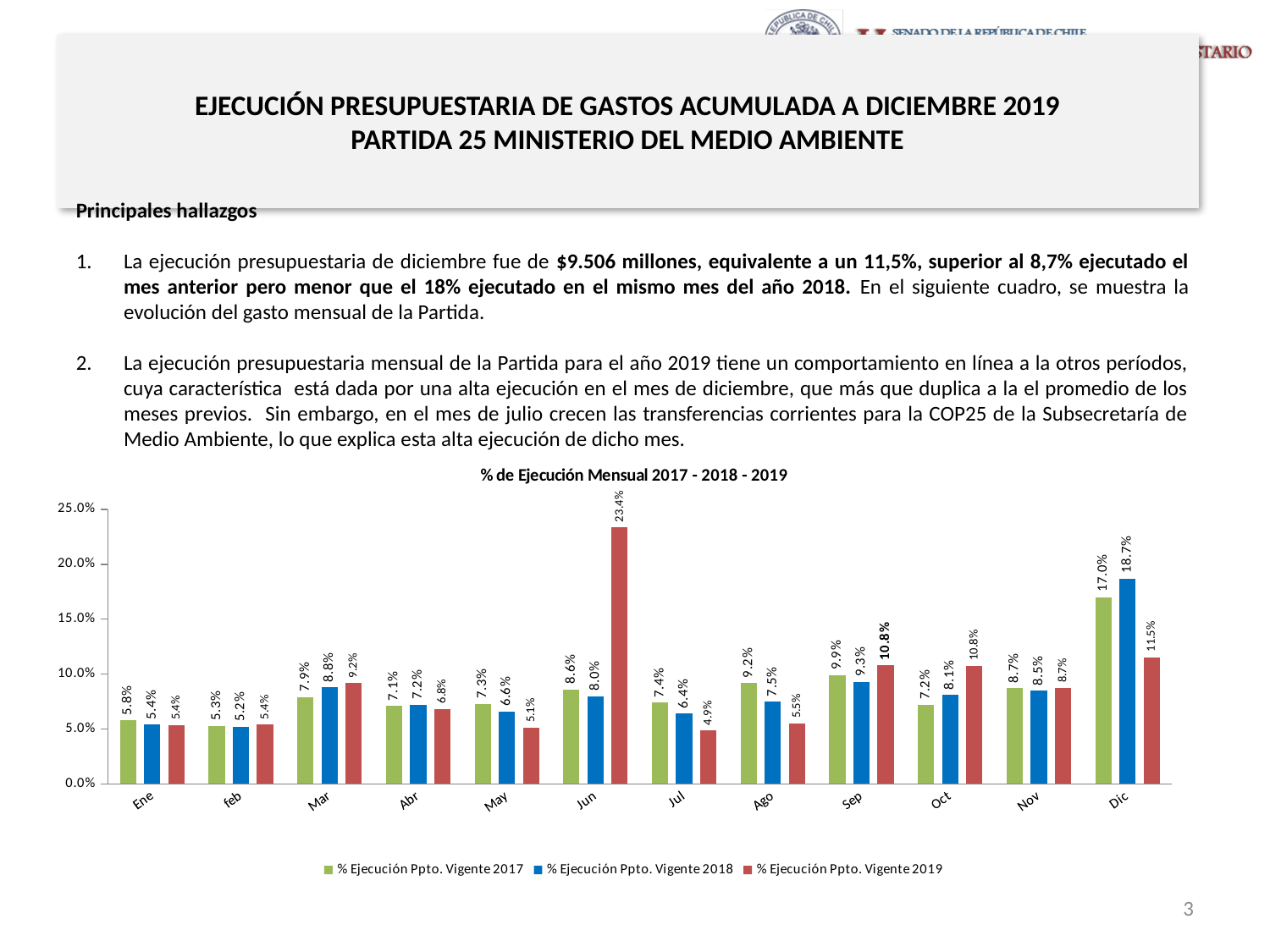
Is the value for % Ejecución Ppto. Vigente 2017 in Dic greater or less than 15.0%? greater What is the value for % Ejecución Ppto. Vigente 2019 in Jun? 23.4% In which month is the % Ejecución Ppto. Vigente 2019 value highest? Jun How many series does the legend of the chart list? 3 What is the value for % Ejecución Ppto. Vigente 2017 in Sep? 9.9% What type of chart is shown on the slide? bar chart How many months are shown on the x axis of the chart? 12 What is the value for % Ejecución Ppto. Vigente 2018 in Dic? 18.7% In which month is the % Ejecución Ppto. Vigente 2019 value lowest? Jul What is the difference between the 2018 and 2019 values in Dic? 7.2% Which is larger in Oct: the 2017 value or the 2019 value? 2019 value What is the title of the chart? % de Ejecución Mensual 2017 - 2018 - 2019